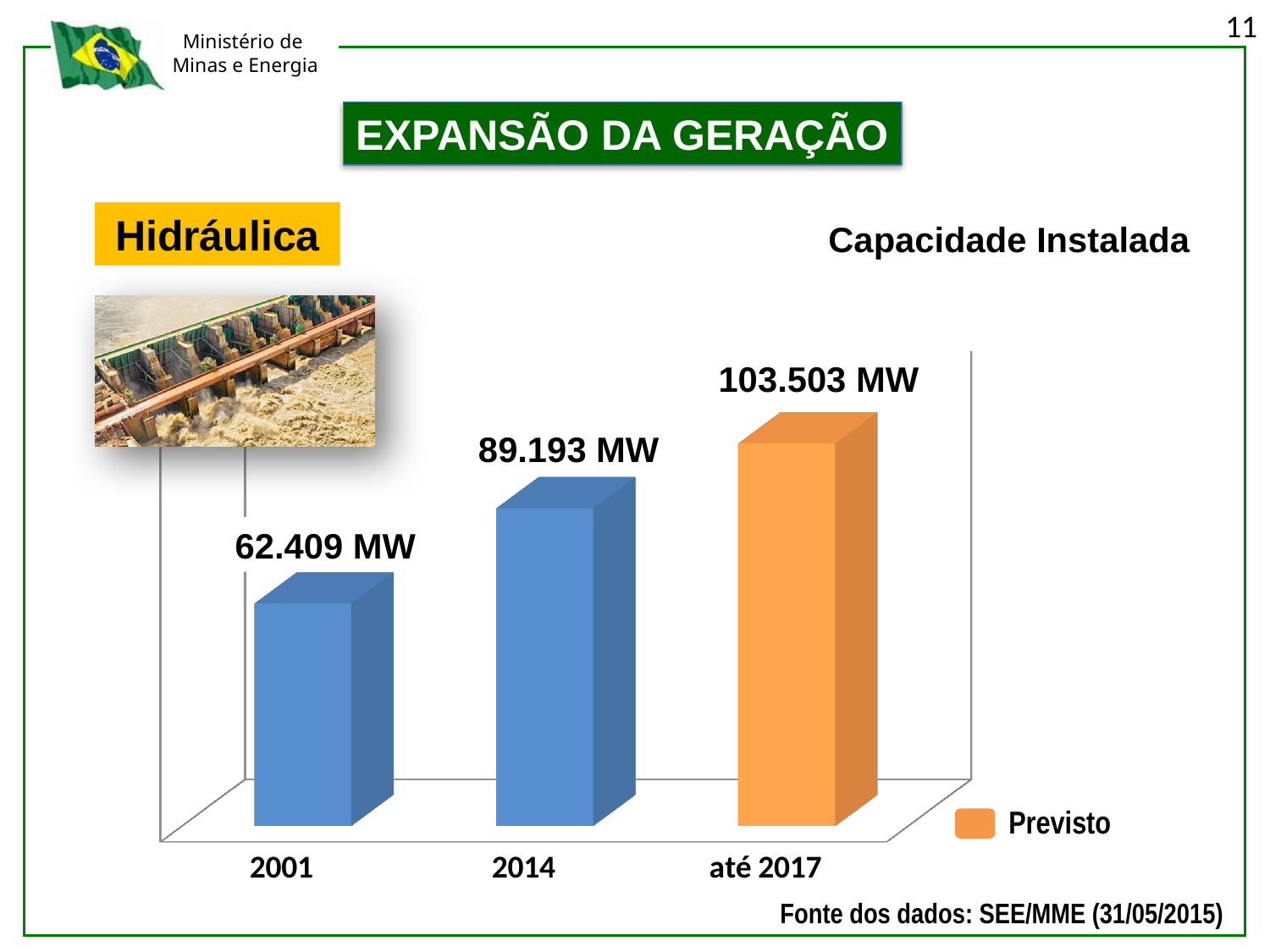
Which category has the lowest installed capacity? 2001 Which is larger, the installed capacity for 2014 or for 2001? 2014 What is the difference in installed capacity between 'até 2017' and 2014? 14.310 MW What is the installed hydraulic capacity shown for 2014? 89.193 MW How many categories are shown on the chart? 3 What is the installed hydraulic capacity shown for 2001? 62.409 MW Do the installed capacity values rise or fall from 2001 to 'até 2017'? Rise What is the difference in installed capacity between 2014 and 2001? 26.784 MW What label does the legend give to the orange bar? Previsto Which category has the highest installed capacity? até 2017 What kind of chart is shown on the slide? Bar chart What is the installed hydraulic capacity forecast for 'até 2017'? 103.503 MW